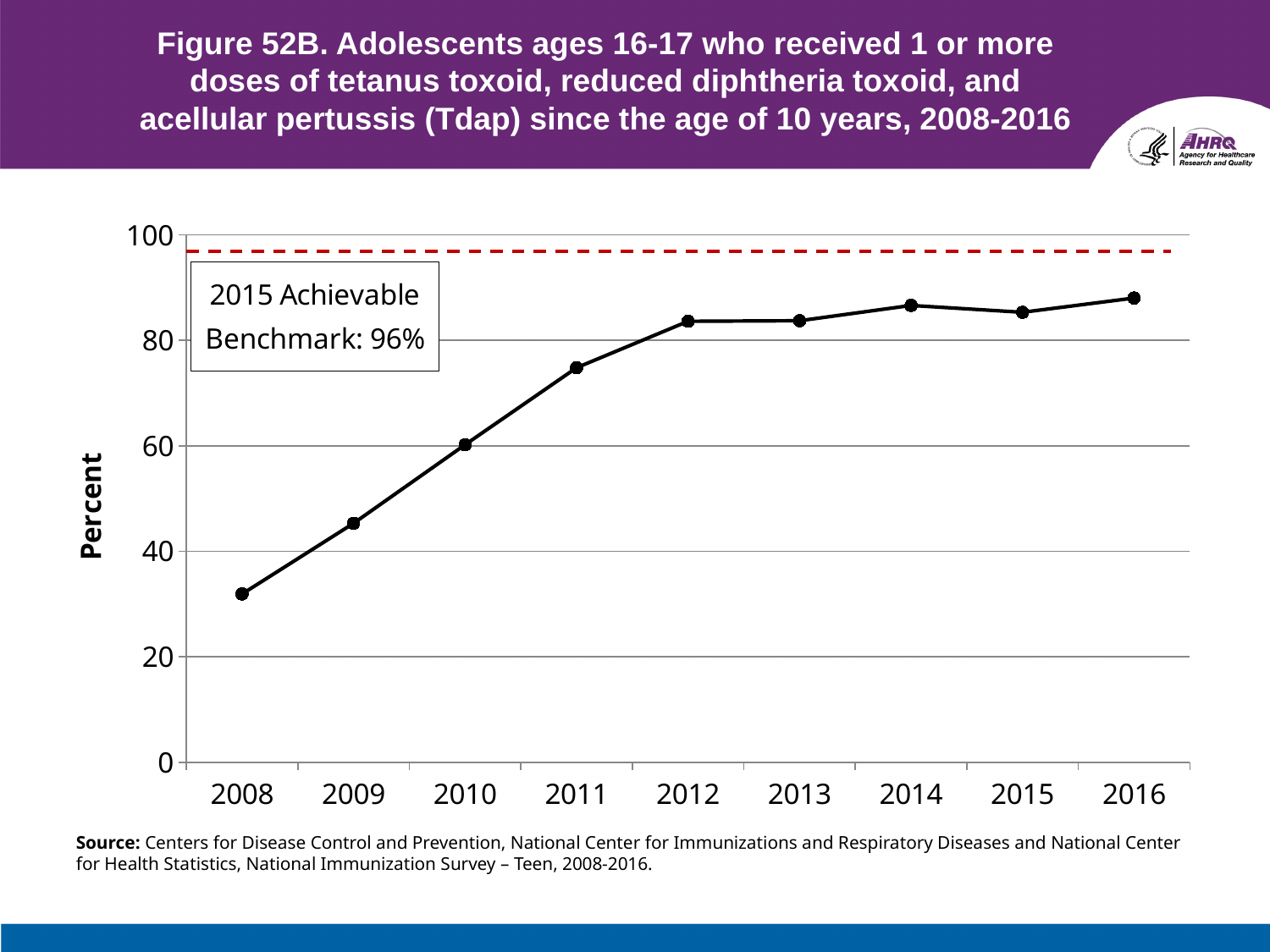
What is the label on the y axis? Percent What is the 2015 Achievable Benchmark shown on the chart? 96% What kind of chart is shown on the slide? line chart Which is larger, the value for 2011 or the value for 2012? 2012 Is the value for 2008 greater or less than 40? less How many years are plotted on the x axis? 9 Which year has the lowest value? 2008 Do the values generally rise or fall from 2008 to 2016? rise Is the value for 2011 greater or less than 80? less Is the value for 2016 greater or less than 80? greater